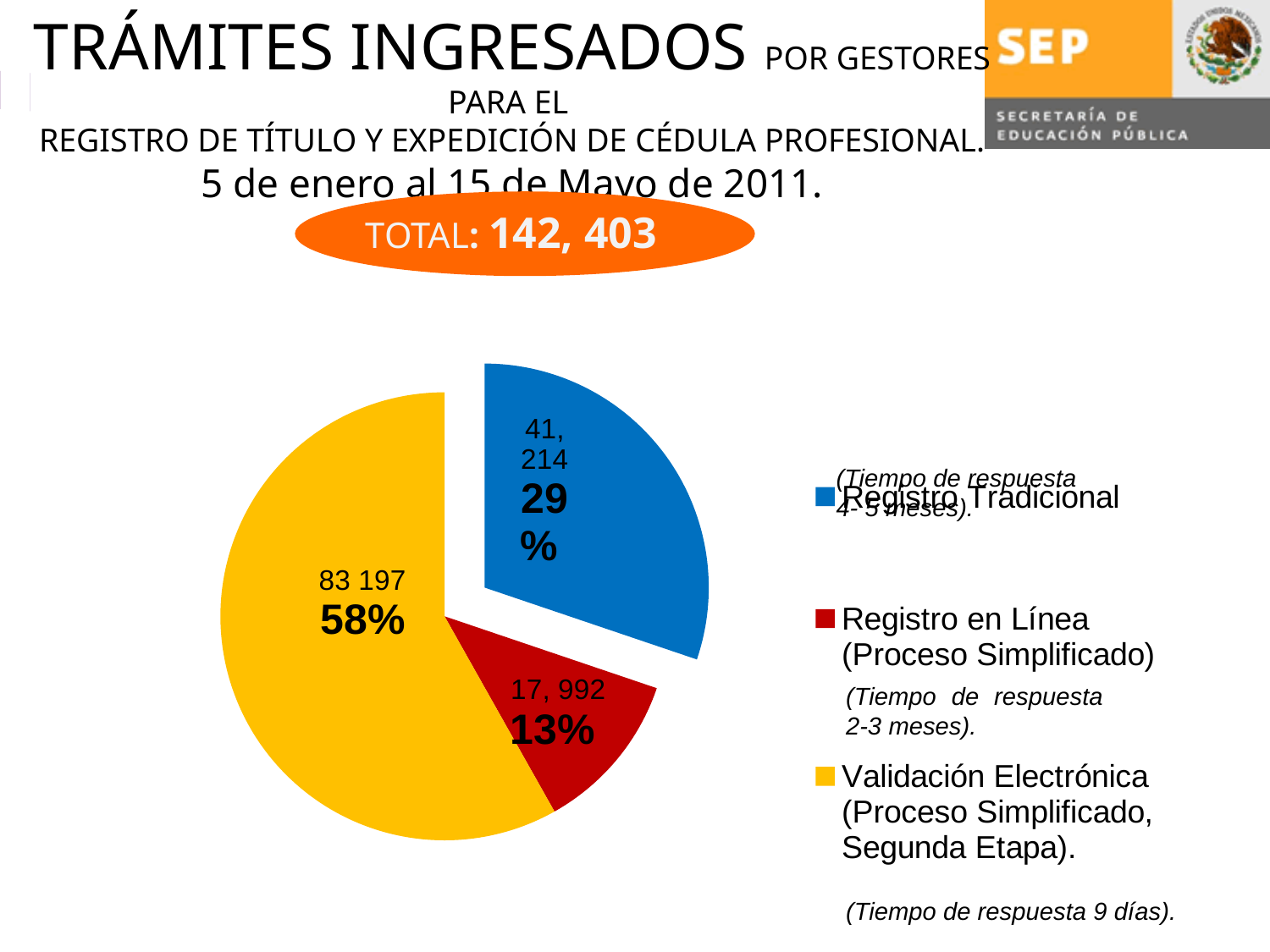
Which category has the largest slice of the pie? Validación Electrónica (Proceso Simplificado, Segunda Etapa) Which category has the smallest slice of the pie? Registro en Línea (Proceso Simplificado) What is the value shown for the Registro Tradicional slice? 41, 214 What percentage of the pie does Registro en Línea (Proceso Simplificado) represent? 13% How many entries does the legend of the pie chart list? 3 How many slices does the pie chart have? 3 Which is larger, the Registro Tradicional slice or the Registro en Línea slice? Registro Tradicional What kind of chart is shown on the slide? pie chart What is the value shown for the Validación Electrónica slice? 83 197 What percentage of the pie does Registro Tradicional represent? 29% What percentage of the pie does Validación Electrónica (Proceso Simplificado, Segunda Etapa) represent? 58% What is the value shown for the Registro en Línea slice? 17, 992